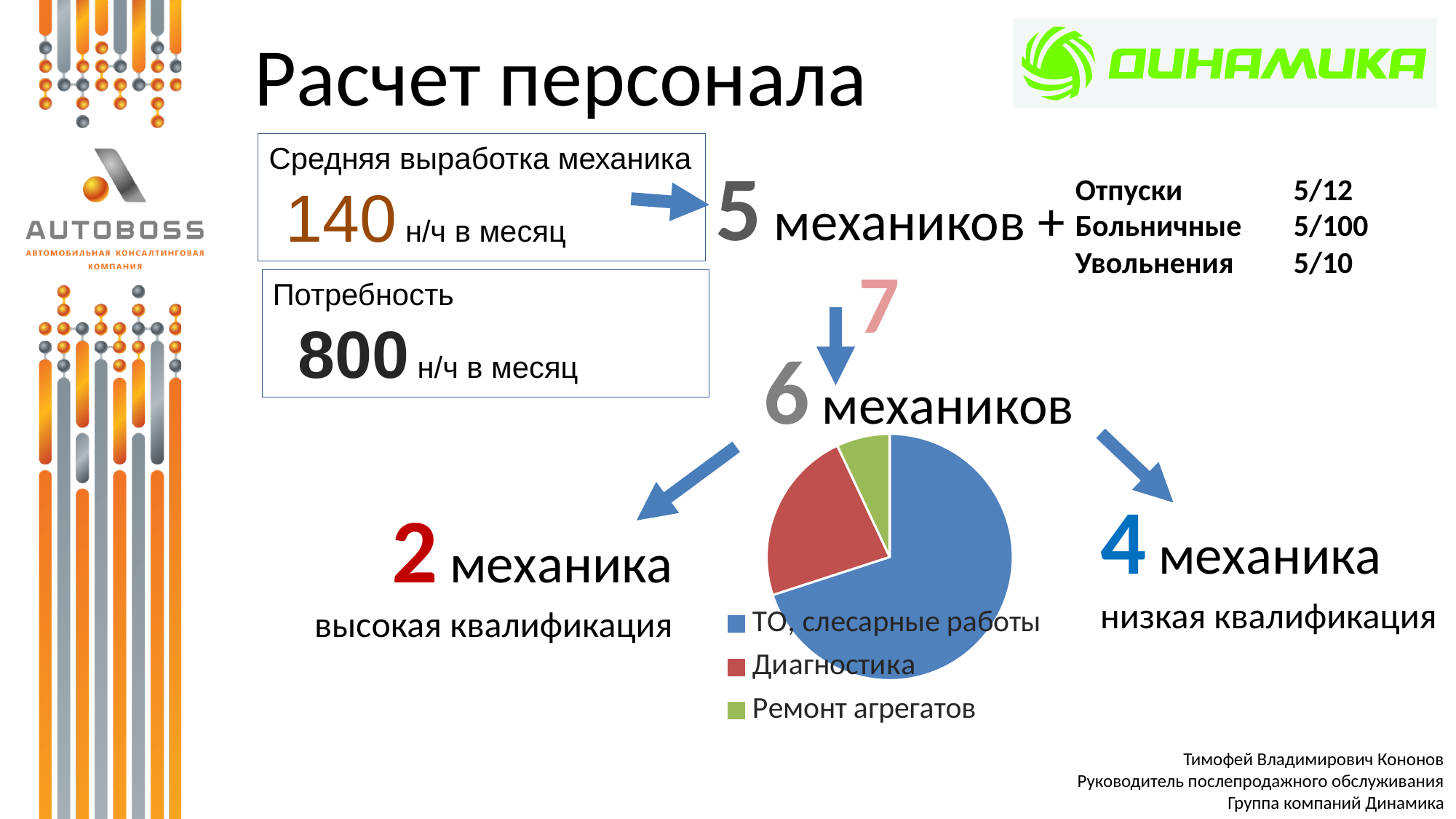
Which slice is larger in the pie chart: ТО, слесарные работы or Диагностика? ТО, слесарные работы Which slice is larger in the pie chart: Диагностика or Ремонт агрегатов? Диагностика What kind of chart is shown on the slide? pie chart How many slices does the pie chart have? 3 How many entries does the pie chart's legend list? 3 Which category has the largest slice of the pie chart? ТО, слесарные работы What colour is the slice for Диагностика in the pie chart? red Which category is shown in green in the pie chart? Ремонт агрегатов Which category has the smallest slice of the pie chart? Ремонт агрегатов